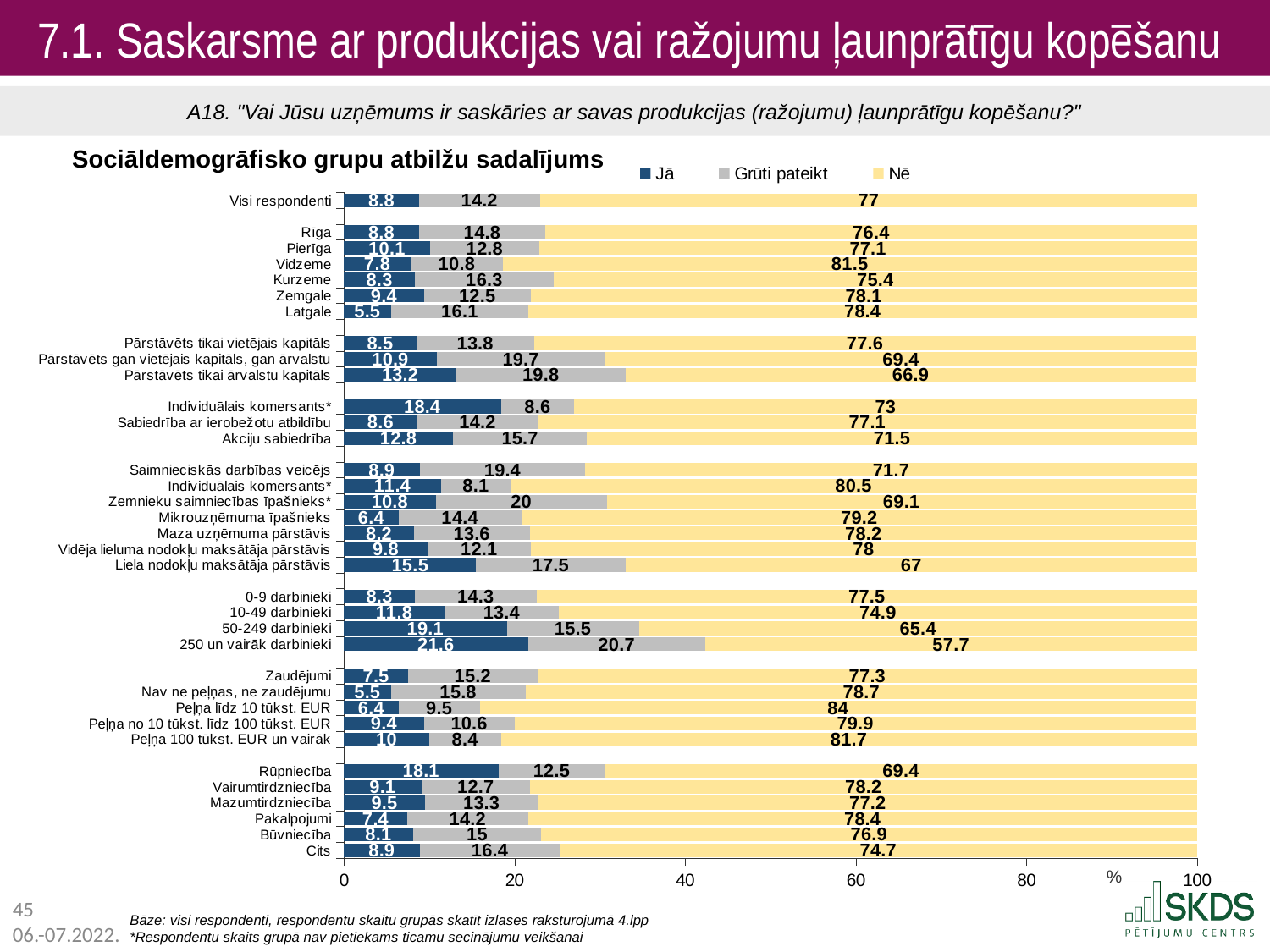
What is the total of the stacked bar for "Visi respondenti"? 100 What kind of chart is shown on the slide? Stacked bar chart What is the value of the "Jā" series for "Rūpniecība"? 18.1 Which category has the highest value in the "Jā" series? 250 un vairāk darbinieki What is the value of the "Nē" series for "Visi respondenti"? 77 What is the difference between the "Jā" values for "Rūpniecība" and "Cits"? 9.2 Which category has the highest value in the "Nē" series? Peļņa līdz 10 tūkst. EUR Which category has the lowest value in the "Nē" series? 250 un vairāk darbinieki How many series does the legend list? 3 What are the three legend entries of the chart? Jā, Grūti pateikt, Nē Which has a larger "Nē" value: "Vidzeme" or "Kurzeme"? Vidzeme What is the value of the "Grūti pateikt" series for "250 un vairāk darbinieki"? 20.7